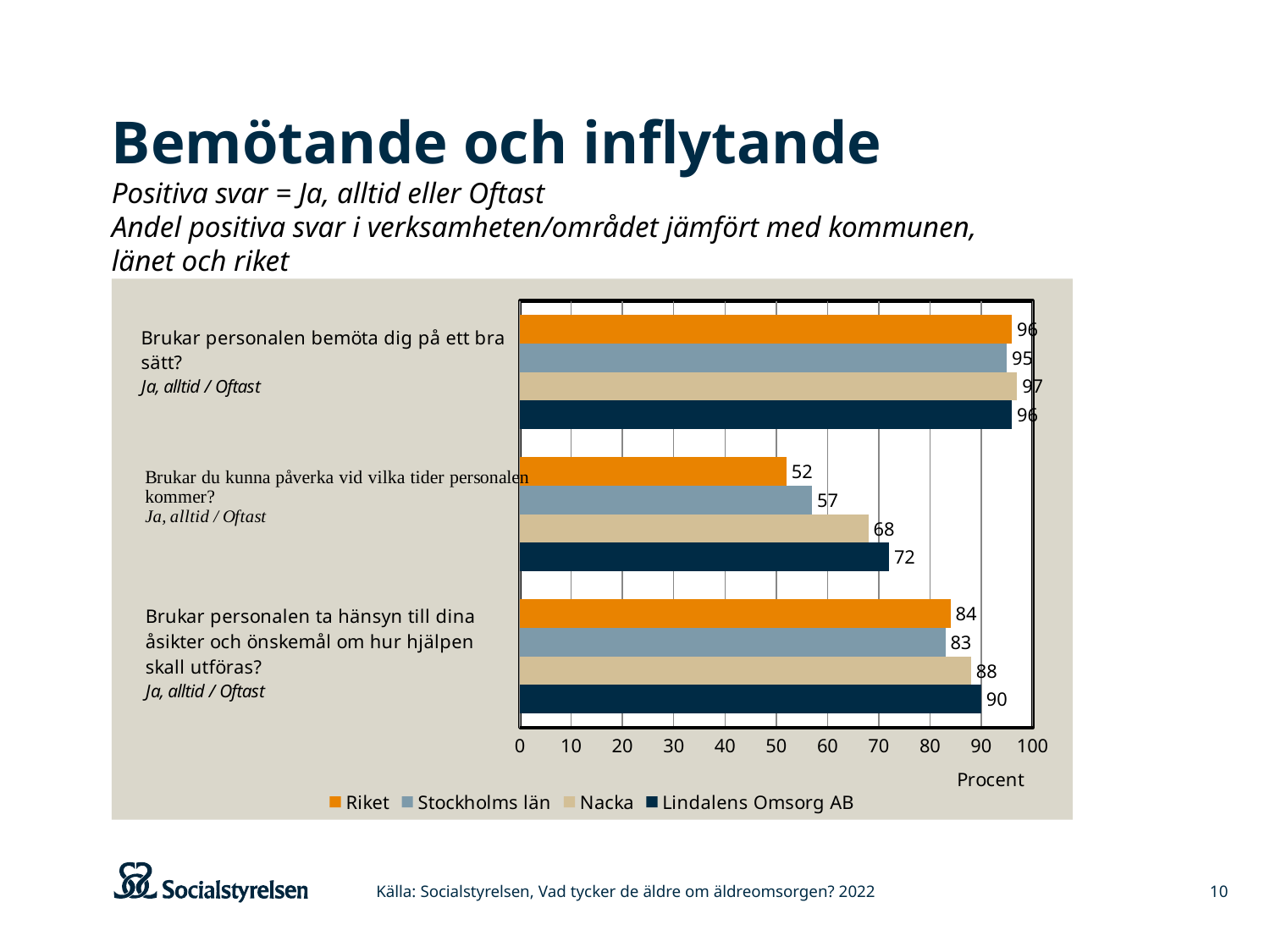
What is the value for Riket for the question 'Brukar personalen ta hänsyn till dina åsikter och önskemål om hur hjälpen skall utföras?' 84 How many series does the legend list? 4 Which series has the lowest value for the question 'Brukar du kunna påverka vid vilka tider personalen kommer?' Riket For the question 'Brukar personalen ta hänsyn till dina åsikter och önskemål om hur hjälpen skall utföras?', which is larger: Nacka or Stockholms län? Nacka What is the value for Lindalens Omsorg AB for the question 'Brukar du kunna påverka vid vilka tider personalen kommer?' 72 What type of chart is shown on the slide? Bar chart What is the difference between Lindalens Omsorg AB and Riket for the question 'Brukar du kunna påverka vid vilka tider personalen kommer?' 20 Which series has the highest value for the question 'Brukar personalen ta hänsyn till dina åsikter och önskemål om hur hjälpen skall utföras?' Lindalens Omsorg AB What label is shown on the horizontal axis of the chart? Procent How many questions (categories) are shown on the chart? 3 Is the value for Stockholms län for the question 'Brukar du kunna påverka vid vilka tider personalen kommer?' greater or less than 60? less What is the value for Nacka for the question 'Brukar personalen bemöta dig på ett bra sätt?' 97